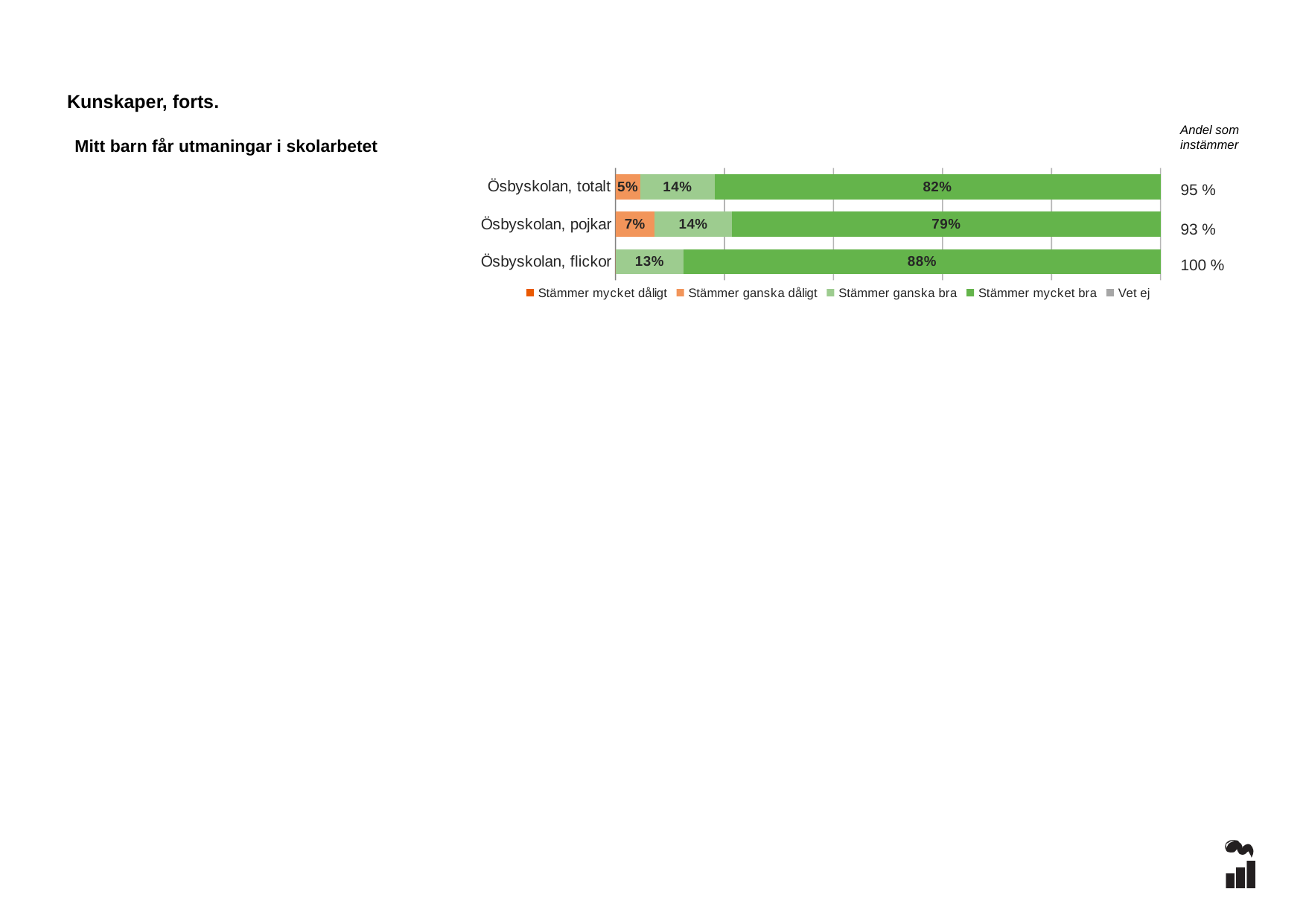
What is the title of the chart? Mitt barn får utmaningar i skolarbetet What is the value of "Stämmer ganska bra" for Ösbyskolan, totalt? 14% What is the difference between the "Stämmer mycket bra" values for Ösbyskolan, flickor and Ösbyskolan, pojkar? 9 percentage points What is the "Andel som instämmer" value shown for Ösbyskolan, pojkar? 93 % Which category has the lowest value for "Stämmer mycket bra"? Ösbyskolan, pojkar What is the value of "Stämmer ganska dåligt" for Ösbyskolan, pojkar? 7% Which category has the highest value for "Stämmer mycket bra"? Ösbyskolan, flickor What kind of chart is shown on the slide? Stacked bar chart What is the value of "Stämmer mycket bra" for Ösbyskolan, flickor? 88% Which is larger: the "Stämmer ganska dåligt" value for Ösbyskolan, pojkar or for Ösbyskolan, totalt? Ösbyskolan, pojkar How many series does the legend list? 5 How many categories (bars) does the chart show? 3